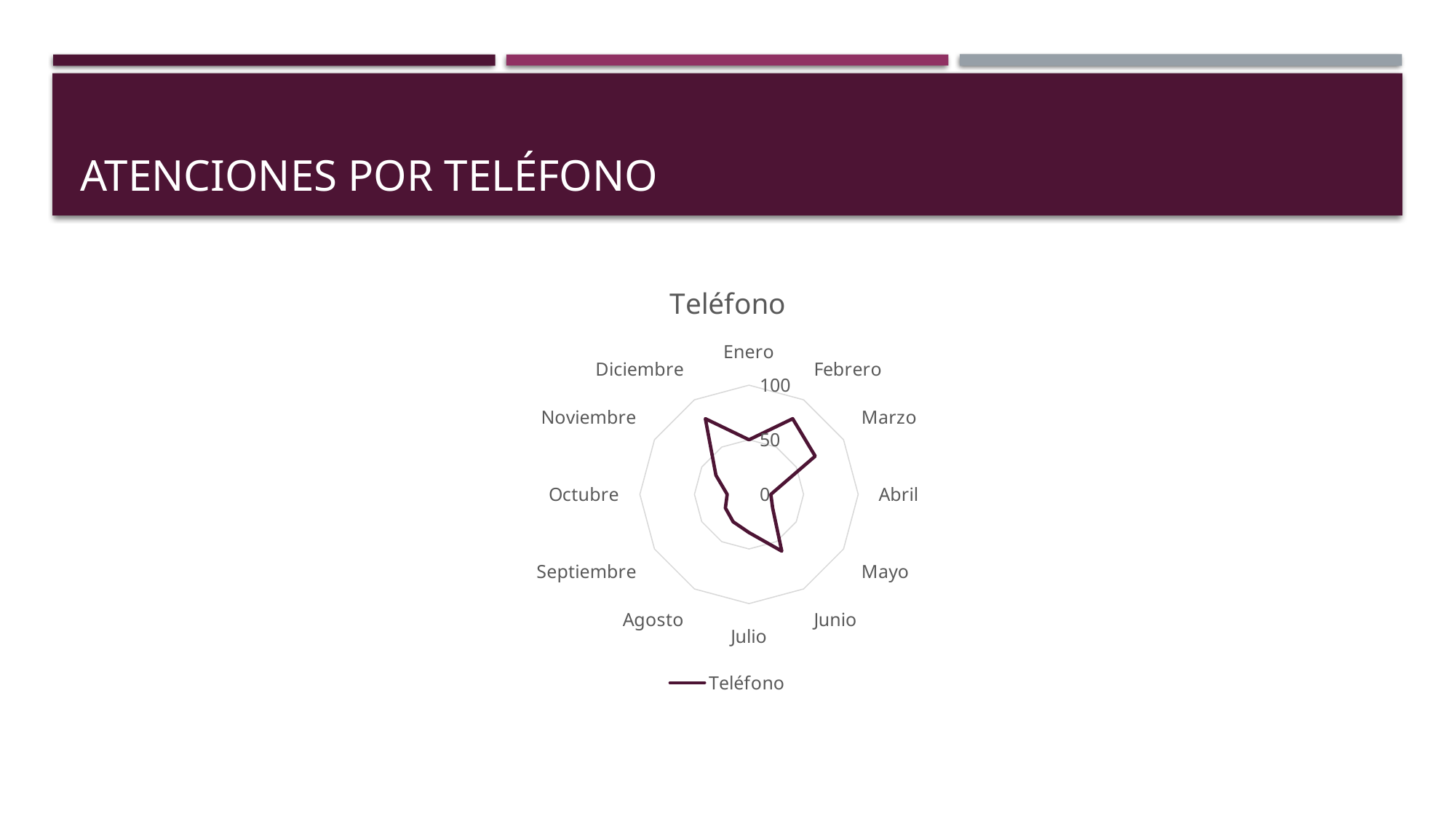
Is the value for Diciembre greater or less than 50? greater Which has the larger value, Diciembre or Octubre? Diciembre What is the highest value shown on the chart's axis? 100 Is the value for Febrero greater or less than 100? less Is the value for Abril greater or less than 50? less What is the title of the chart? Teléfono Which has the larger value, Febrero or Abril? Febrero How many categories (months) does the chart have? 12 What kind of chart is shown on the slide? Radar chart How many series does the legend list? 1